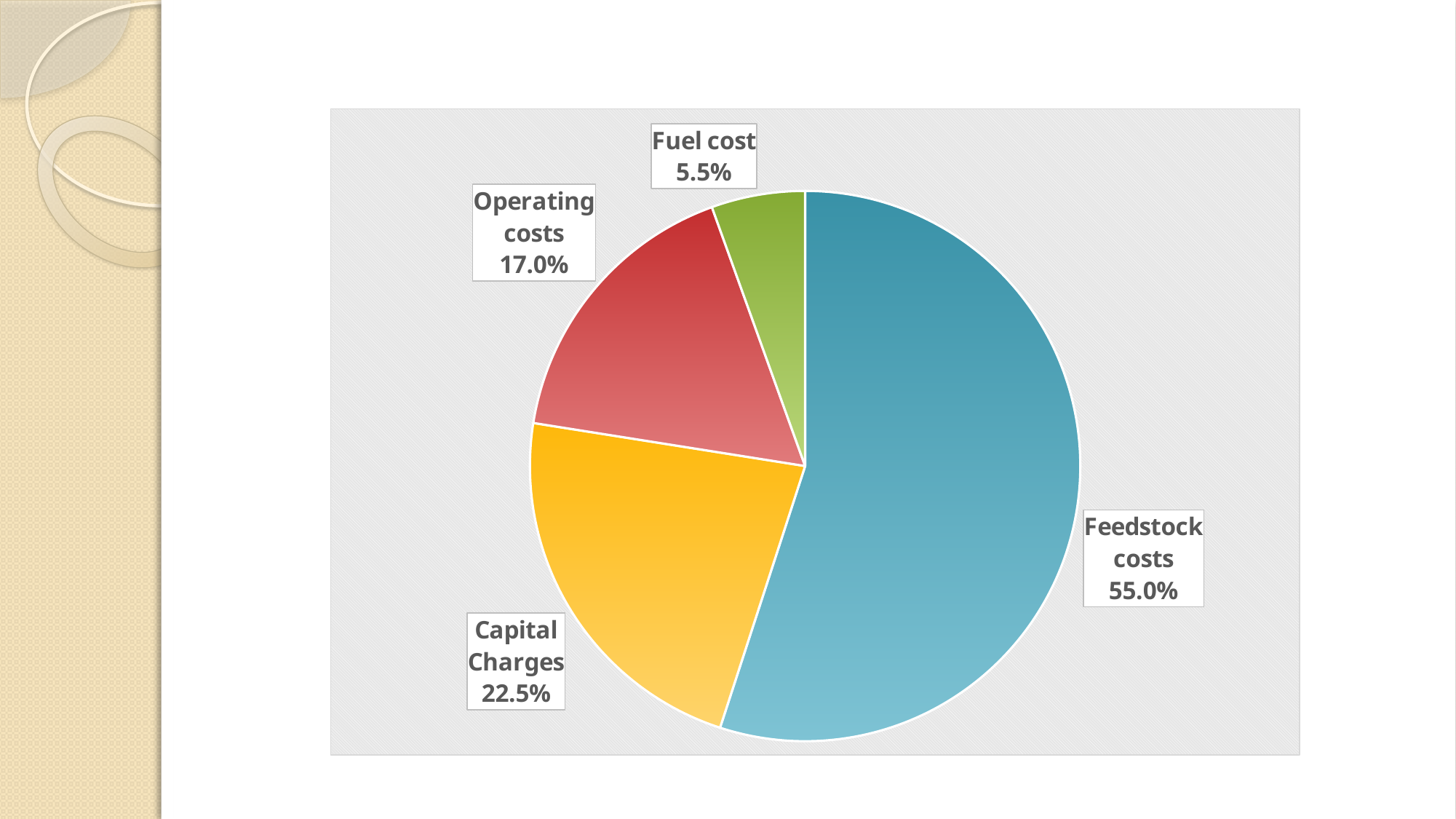
What is the difference between the Capital Charges share and the Operating costs share? 5.5% Which category has the largest slice of the pie? Feedstock costs What share of the pie is Feedstock costs? 55.0% What kind of chart is shown on the slide? pie chart How many slices does the pie chart have? 4 Which category has the smallest slice of the pie? Fuel cost What is the value shown for Capital Charges? 22.5% What is the value shown for Operating costs? 17.0% What is the difference between the Feedstock costs share and the Capital Charges share? 32.5% Which is larger, Operating costs or Fuel cost? Operating costs What colour is the Feedstock costs slice? blue What is the value shown for Fuel cost? 5.5%